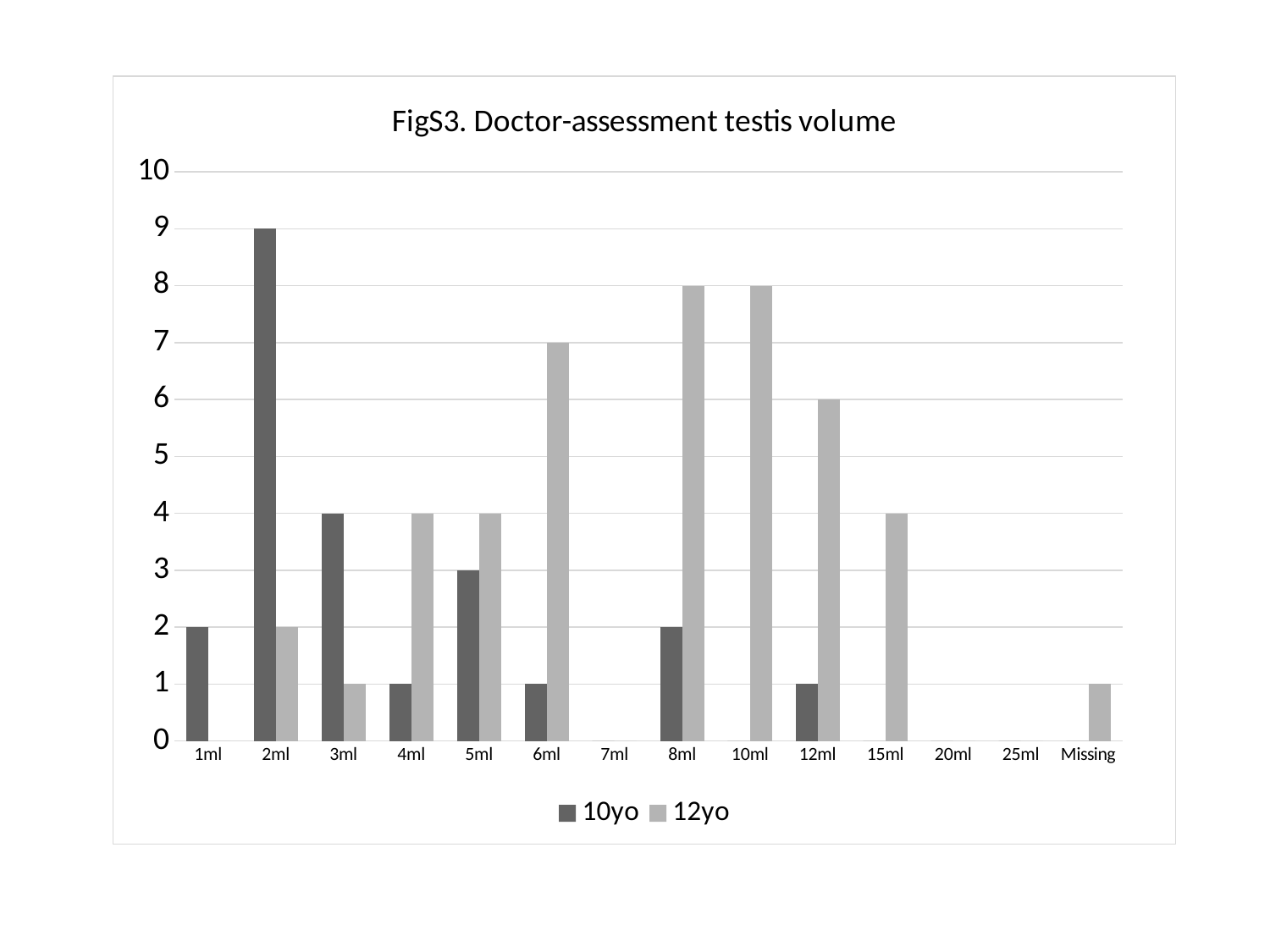
What is the value for 10yo at 2ml? 9 What is the value for 12yo at 12ml? 6 What is the title of the chart? FigS3. Doctor-assessment testis volume How many categories are shown on the x axis? 14 How many series does the legend list? 2 What type of chart is shown on the slide? bar chart Which is larger at 5ml, the 10yo value or the 12yo value? 12yo What is the value for 12yo in the Missing category? 1 What is the value for 12yo at 6ml? 7 What is the difference between the 10yo and 12yo values at 2ml? 7 Which category has the highest value for the 10yo series? 2ml Is the value for 12yo at 10ml greater or less than 5? greater